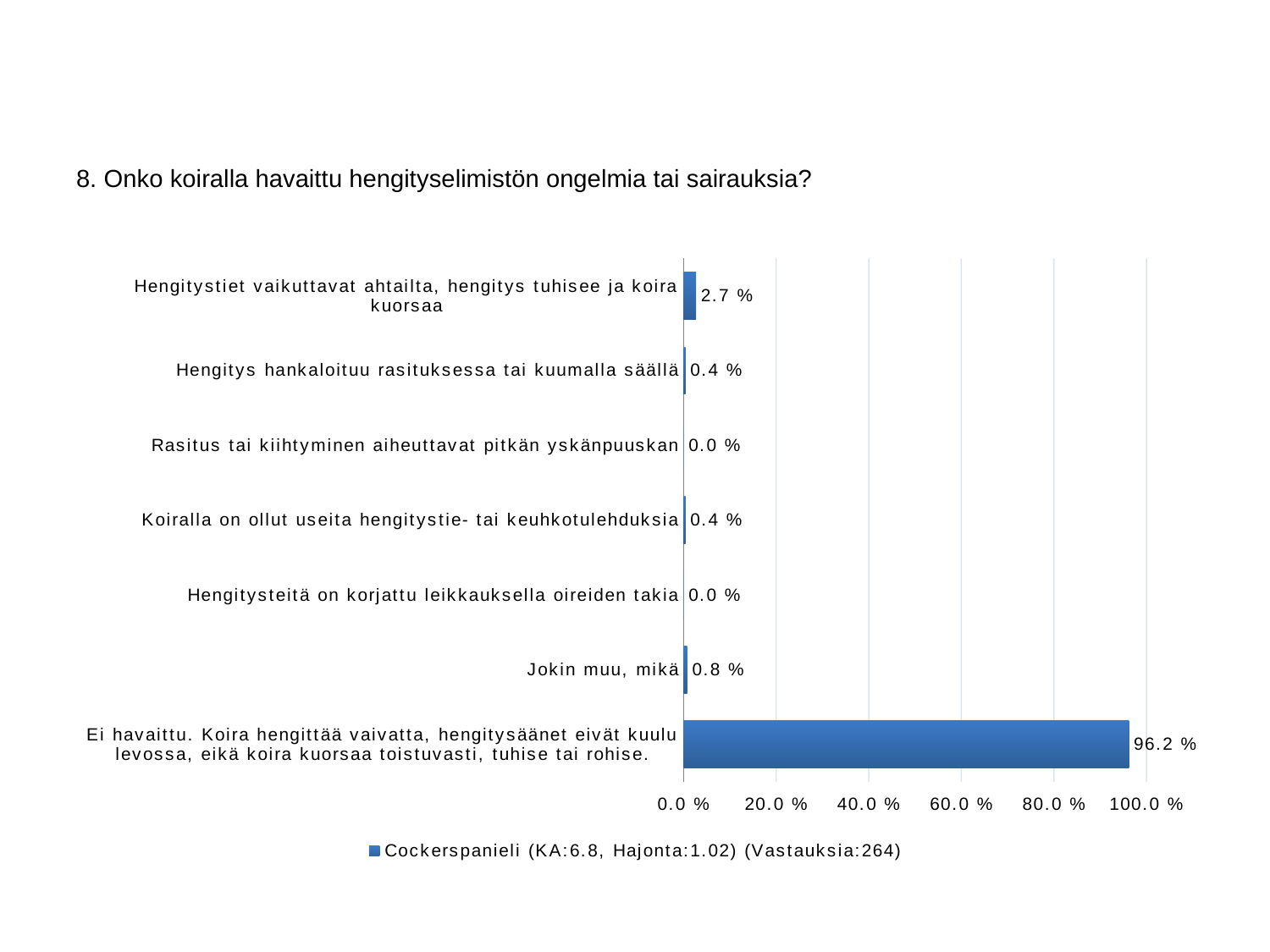
What is the value for "Ei havaittu. Koira hengittää vaivatta, hengitysäänet eivät kuulu levossa, eikä koira kuorsaa toistuvasti, tuhise tai rohise."? 96.2 % How many series does the legend list? 1 Which is larger: the value for "Hengitystiet vaikuttavat ahtailta, hengitys tuhisee ja koira kuorsaa" or the value for "Jokin muu, mikä"? Hengitystiet vaikuttavat ahtailta, hengitys tuhisee ja koira kuorsaa What is the value for "Jokin muu, mikä"? 0.8 % Which category has the highest value? Ei havaittu. Koira hengittää vaivatta, hengitysäänet eivät kuulu levossa, eikä koira kuorsaa toistuvasti, tuhise tai rohise. What kind of chart is shown on the slide? bar chart What is the value for "Hengitystiet vaikuttavat ahtailta, hengitys tuhisee ja koira kuorsaa"? 2.7 % What is the value for "Hengitys hankaloituu rasituksessa tai kuumalla säällä"? 0.4 % Is the value for "Ei havaittu. Koira hengittää vaivatta, hengitysäänet eivät kuulu levossa, eikä koira kuorsaa toistuvasti, tuhise tai rohise." greater or less than 80.0 %? greater How many responses (Vastauksia) does the legend entry report? 264 How many categories are shown in the chart? 7 What is the difference between the values for "Hengitystiet vaikuttavat ahtailta, hengitys tuhisee ja koira kuorsaa" and "Jokin muu, mikä"? 1.9 %